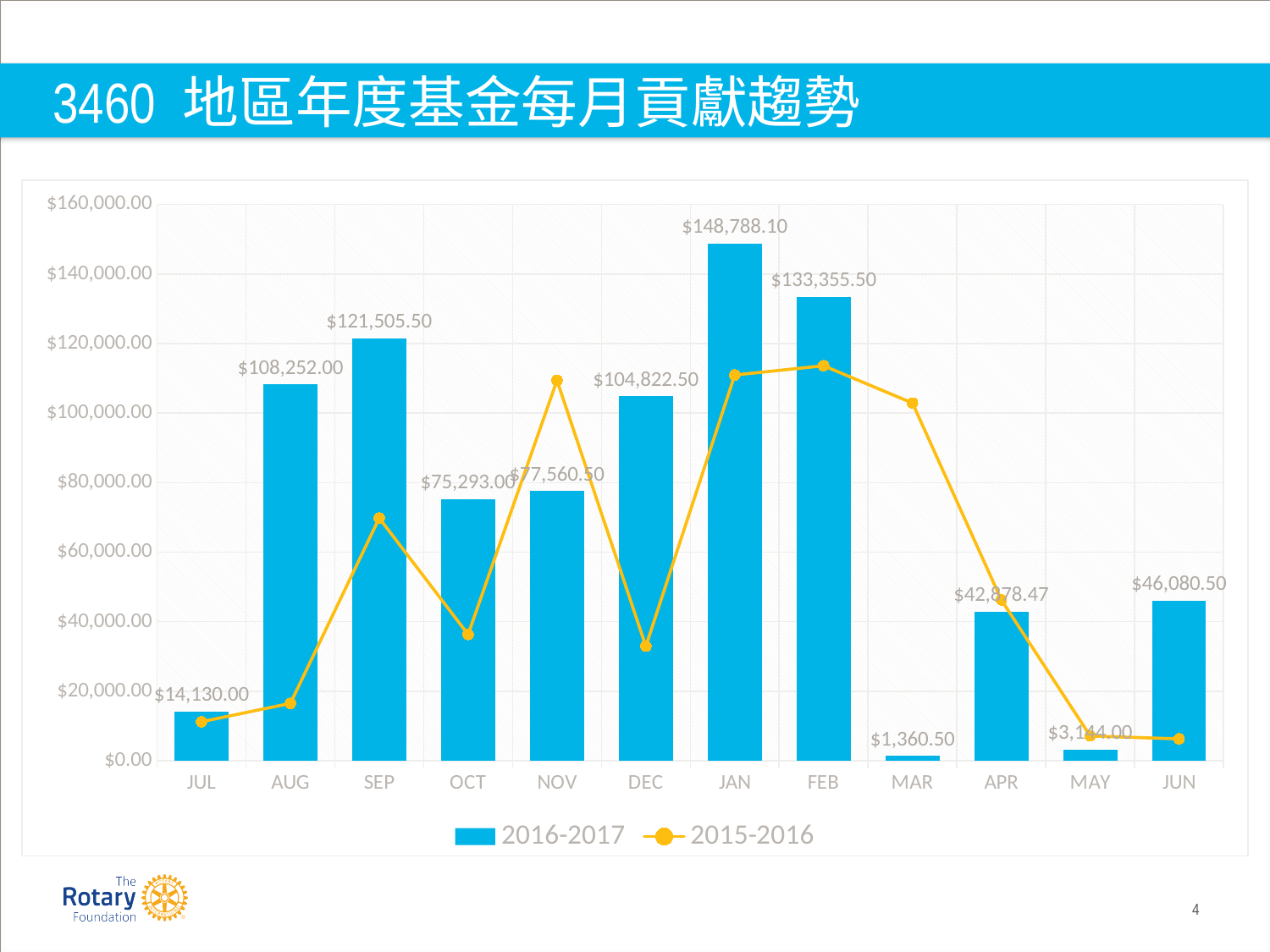
In NOV, which series has the larger value, 2016-2017 or 2015-2016? 2015-2016 What kind of chart is shown on the slide? A combined bar and line chart What is the 2016-2017 value for JAN? $148,788.10 What is the 2016-2017 value for SEP? $121,505.50 Which month has the lowest 2016-2017 value? MAR Is the 2015-2016 value for DEC greater or less than $40,000.00? less How many series does the legend list? 2 Is the 2015-2016 value for FEB greater or less than $100,000.00? greater What is the difference between the 2016-2017 values for JAN and FEB? $15,432.60 How many months are shown on the x axis? 12 Which month has the highest 2016-2017 value? JAN What is the 2016-2017 value for MAR? $1,360.50